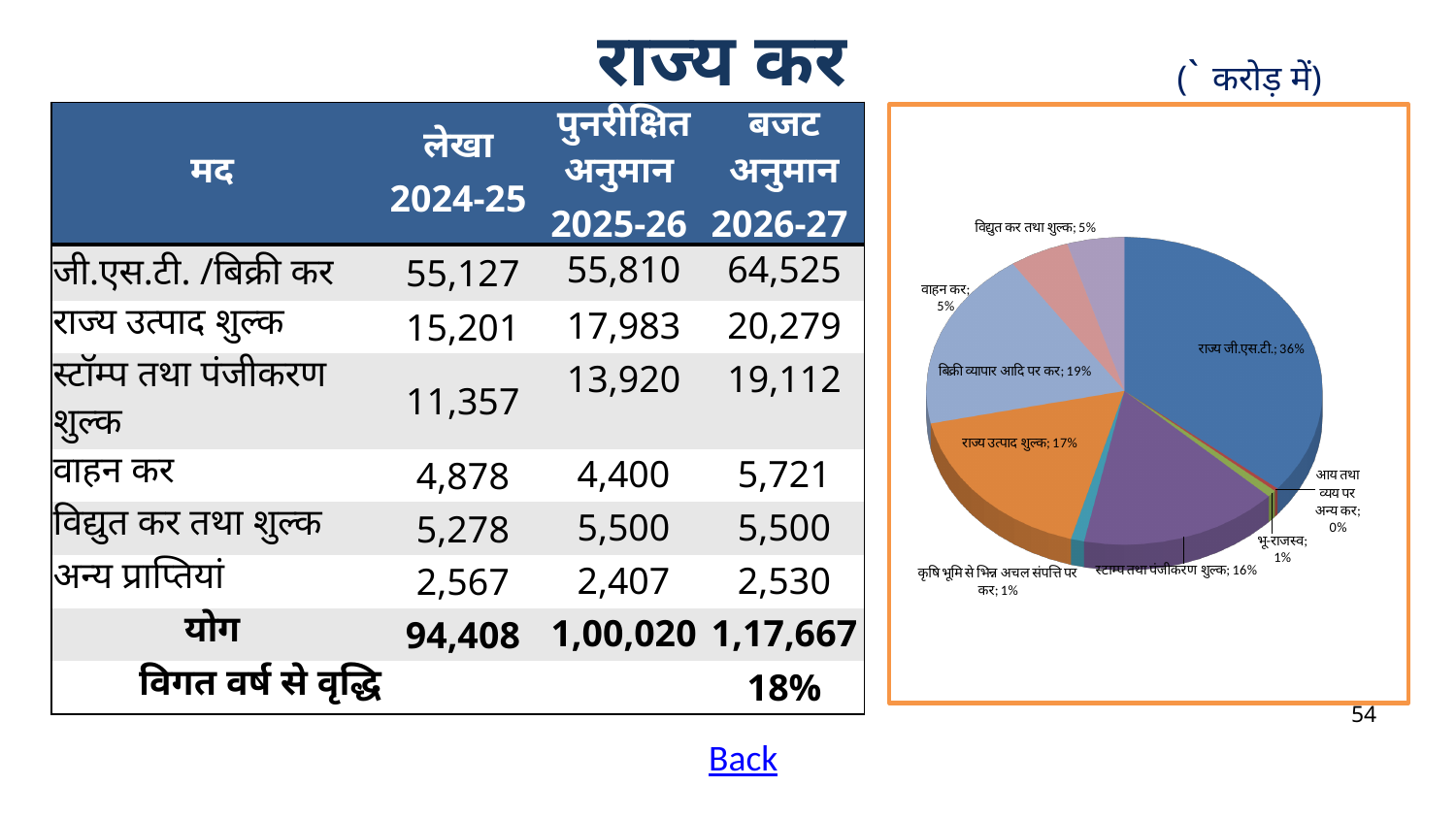
In the pie chart, what share is shown for वाहन कर? 5% In the pie chart, what is the difference in percentage points between राज्य जी.एस.टी. and राज्य उत्पाद शुल्क? 19 In the pie chart, what share is shown for राज्य जी.एस.टी.? 36% In the pie chart, what share is shown for स्टाम्प तथा पंजीकरण शुल्क? 16% Which slice of the pie chart has the smallest share? आय तथा व्यय पर अन्य कर How many slices are labelled in the pie chart? 9 Which slice of the pie chart has the largest share? राज्य जी.एस.टी. What kind of chart is shown on the right side of the slide? Pie chart